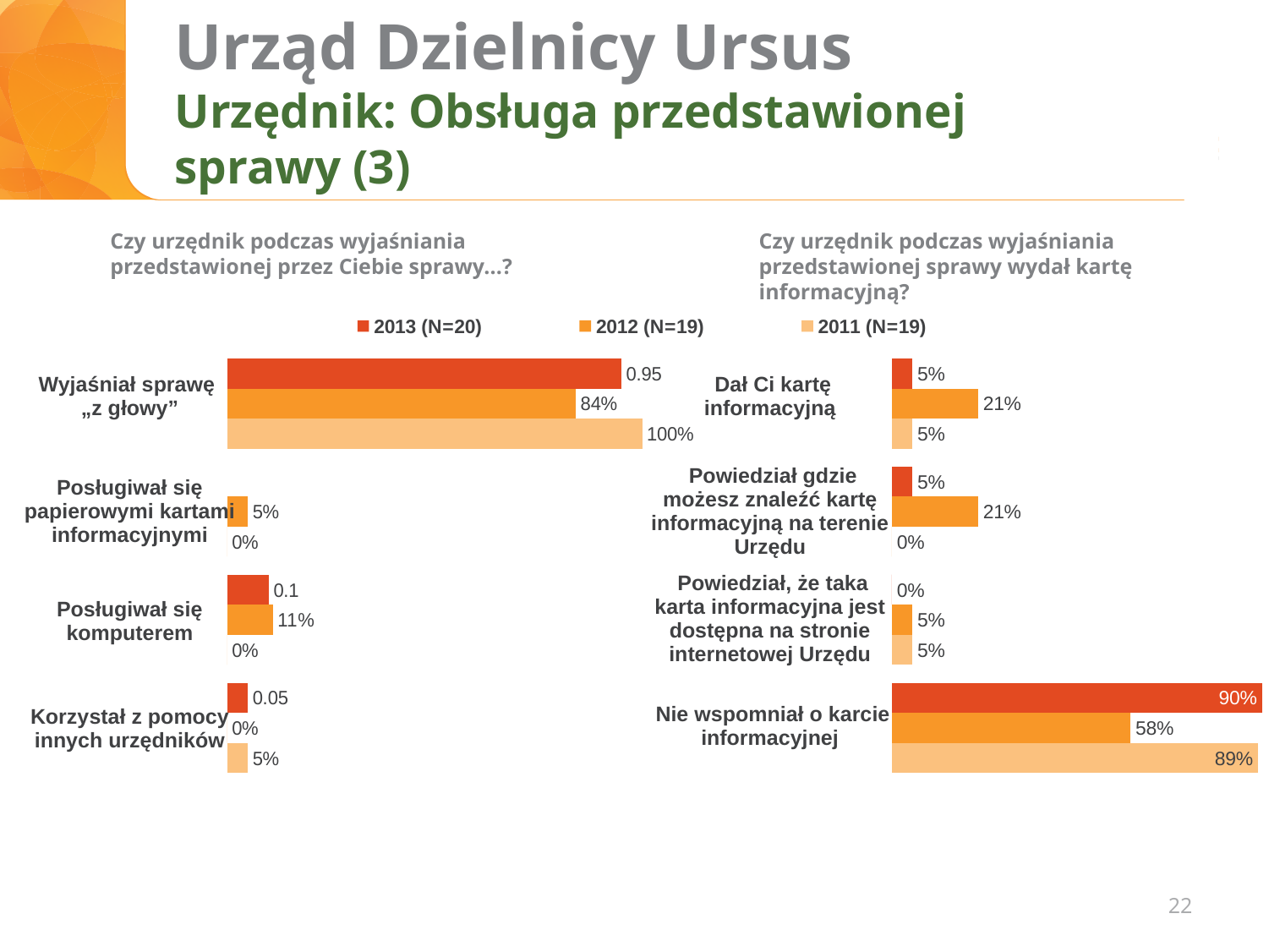
In the right chart ("Czy urzędnik podczas wyjaśniania przedstawionej sprawy wydał kartę informacyjną?"), what is the 2013 (N=20) value for "Nie wspomniał o karcie informacyjnej"? 90% In the left chart ("Czy urzędnik podczas wyjaśniania przedstawionej przez Ciebie sprawy...?"), what is the 2012 (N=19) value for "Wyjaśniał sprawę „z głowy”"? 84% In the right chart, for "Nie wspomniał o karcie informacyjnej", which is larger: the 2013 (N=20) value or the 2011 (N=19) value? 2013 (N=20) In the left chart, what is the 2011 (N=19) value for "Korzystał z pomocy innych urzędników"? 5% In the right chart, which category has the highest 2012 (N=19) value? Nie wspomniał o karcie informacyjnej In the left chart, what is the 2011 (N=19) value for "Wyjaśniał sprawę „z głowy”"? 100% In the right chart, what is the 2011 (N=19) value for "Powiedział gdzie możesz znaleźć kartę informacyjną na terenie Urzędu"? 0% What type of chart is the right chart? Bar chart How many series does the legend list? 3 In the left chart, what is the 2012 (N=19) value for "Posługiwał się komputerem"? 11% In the right chart, what is the 2012 (N=19) value for "Dał Ci kartę informacyjną"? 21% In the right chart, what is the difference between the 2013 (N=20) and 2012 (N=19) values for "Nie wspomniał o karcie informacyjnej"? 32 percentage points